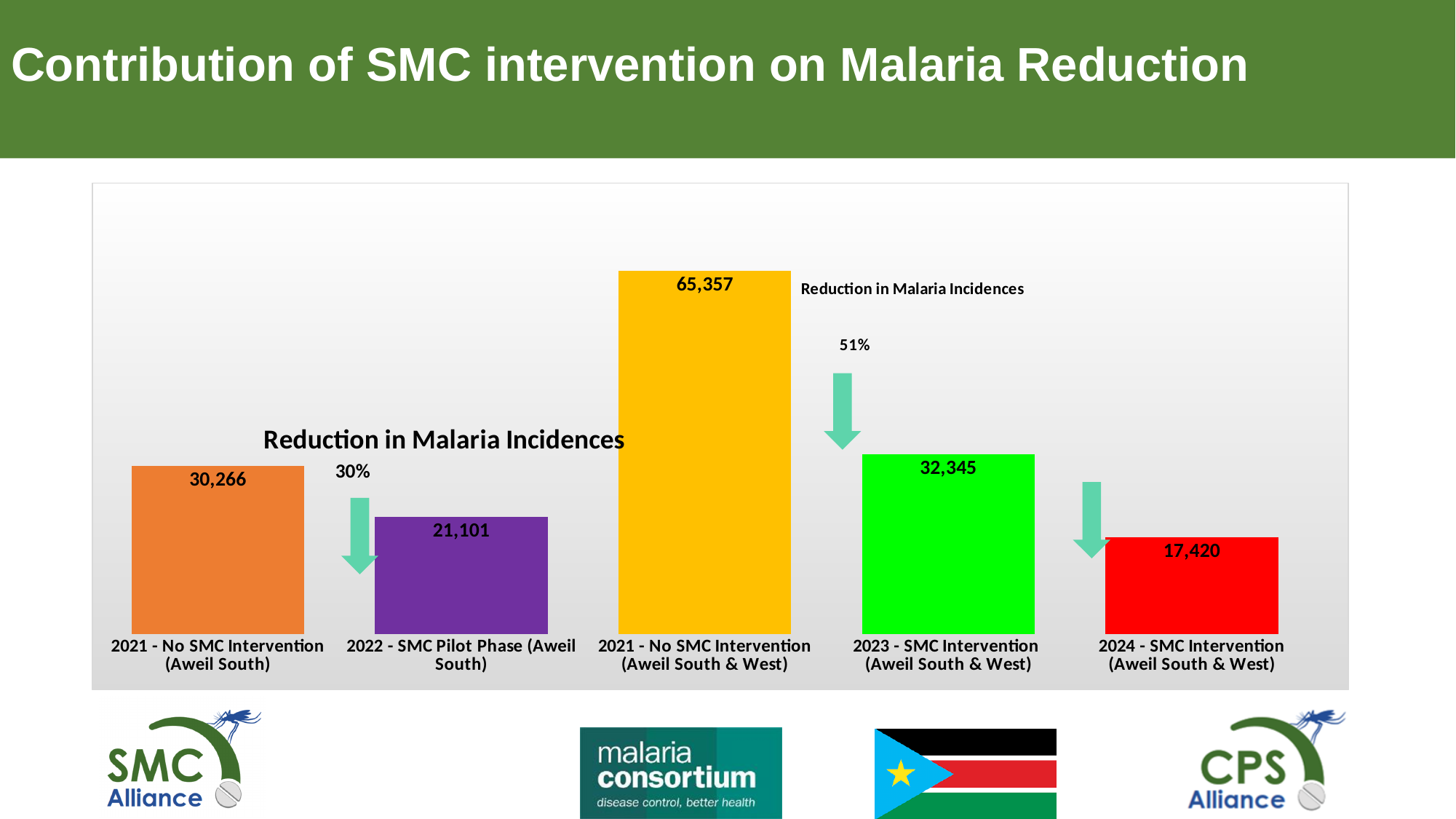
Which category has the lowest value? 2024 - SMC Intervention (Aweil South & West) How many bars are shown in the chart? 5 What is the value for 2021 - No SMC Intervention (Aweil South)? 30,266 What is the value for 2024 - SMC Intervention (Aweil South & West)? 17,420 What kind of chart is shown on the slide? Bar chart Which category has the highest value? 2021 - No SMC Intervention (Aweil South & West) Which is larger, the value for 2023 - SMC Intervention (Aweil South & West) or the value for 2021 - No SMC Intervention (Aweil South)? 2023 - SMC Intervention (Aweil South & West) What is the difference between the values for 2021 - No SMC Intervention (Aweil South & West) and 2023 - SMC Intervention (Aweil South & West)? 33,012 What is the difference between the values for 2021 - No SMC Intervention (Aweil South) and 2022 - SMC Pilot Phase (Aweil South)? 9,165 What is the value for 2021 - No SMC Intervention (Aweil South & West)? 65,357 What is the value for 2022 - SMC Pilot Phase (Aweil South)? 21,101 What percentage reduction in malaria incidences is annotated between the 2021 (Aweil South & West) bar and the 2023 bar? 51%